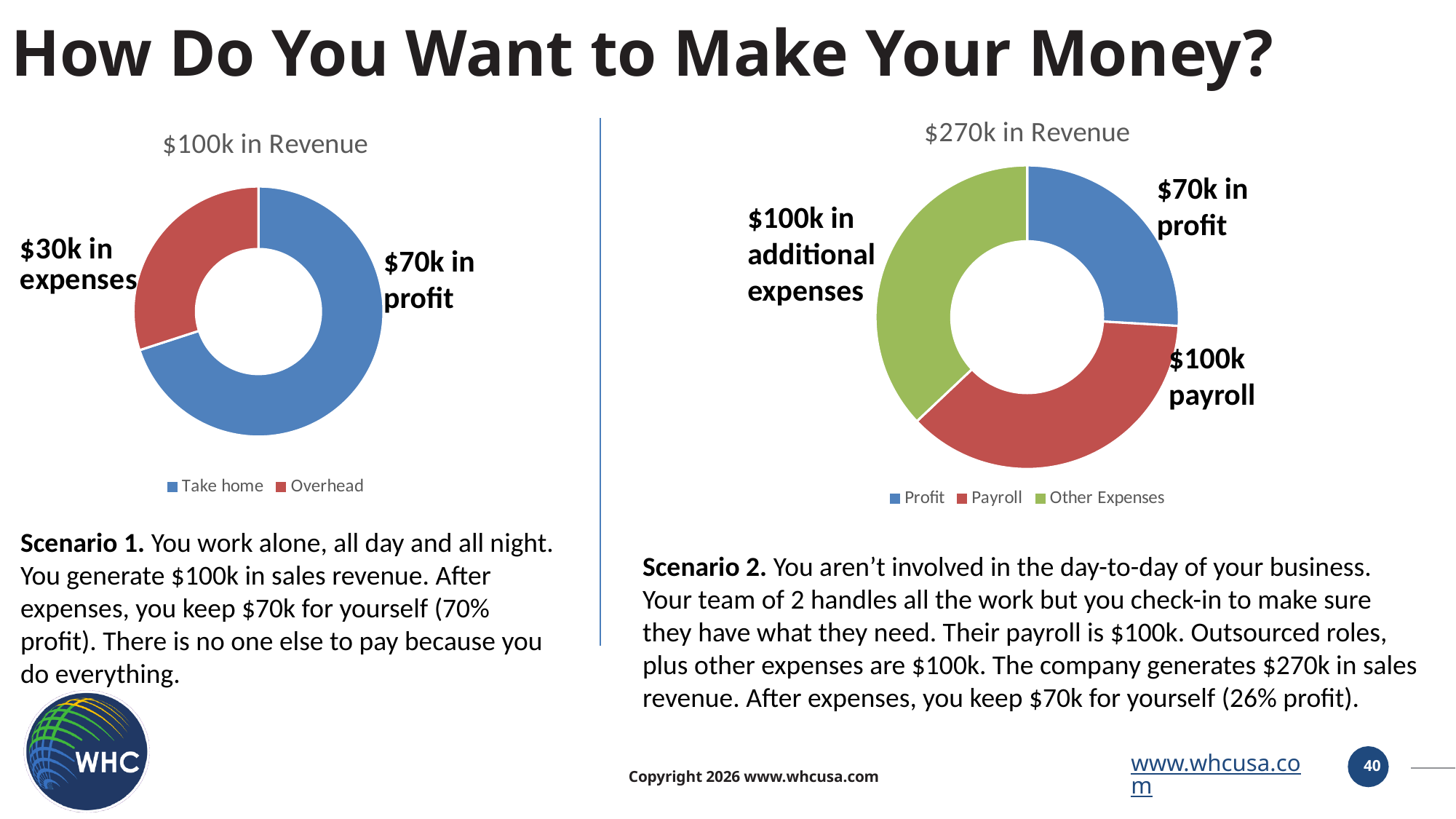
In the '$100k in Revenue' chart, which segment is larger, Take home or Overhead? Take home In the '$100k in Revenue' chart, what share of revenue is the Take home segment? 70% How many entries does the legend of the '$100k in Revenue' chart list? 2 How many segments does the '$270k in Revenue' chart have? 3 In the '$270k in Revenue' chart, what is the difference between payroll and profit? $30k In the '$100k in Revenue' chart, what value is labelled for profit? $70k In the '$100k in Revenue' chart, what value is labelled for expenses? $30k In the '$270k in Revenue' chart, which segment is the smallest? Profit In the '$100k in Revenue' chart, what is the difference between the profit and the expenses? $40k In the '$270k in Revenue' chart, what value is labelled for profit? $70k In the '$270k in Revenue' chart, what value is labelled for payroll? $100k What kind of chart is the '$270k in Revenue' chart? Doughnut chart